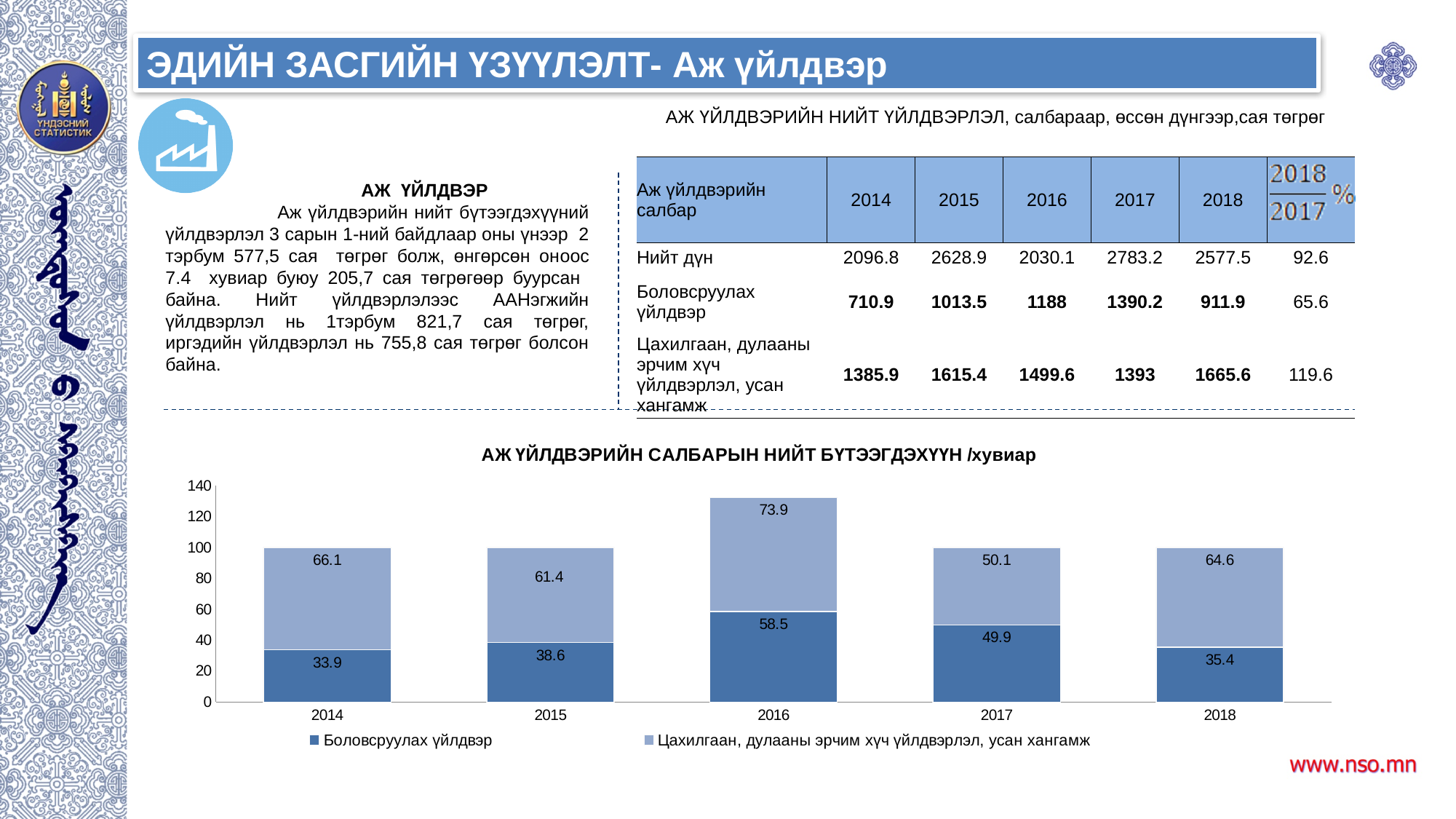
How many series does the legend list? 2 What is the total of the stacked bar for 2016? 132.4 How many years are shown on the x axis? 5 What type of chart is shown on the slide? stacked bar chart What is the value for Цахилгаан, дулааны эрчим хүч үйлдвэрлэл, усан хангамж in 2017? 50.1 In which year is the value for Боловсруулах үйлдвэр lowest? 2014 Is the total of the stacked bar for 2016 greater or less than 120? greater What is the difference between the Цахилгаан, дулааны эрчим хүч үйлдвэрлэл, усан хангамж values in 2014 and 2015? 4.7 Which is larger: the Боловсруулах үйлдвэр value in 2015 or in 2018? 2015 What is the value for Боловсруулах үйлдвэр in 2014? 33.9 What is the value for Боловсруулах үйлдвэр in 2016? 58.5 In which year is the value for Боловсруулах үйлдвэр highest? 2016